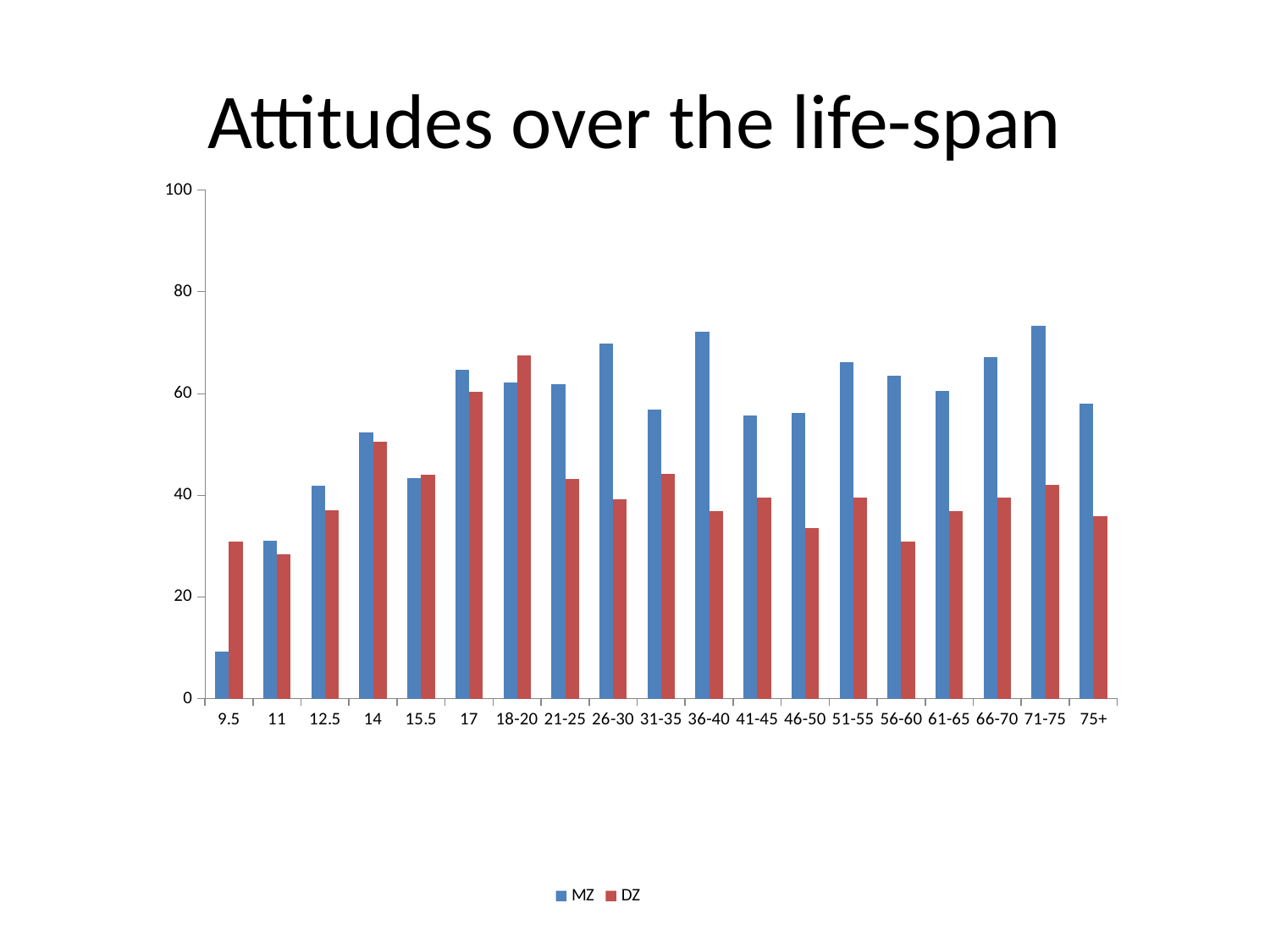
How many age categories are shown on the x axis? 19 Is the MZ value for 9.5 greater or less than 20? less For the 9.5 category, which series has the larger value, MZ or DZ? DZ Is the DZ value for 18-20 greater or less than 60? greater What is the title of the chart? Attitudes over the life-span For the 36-40 category, which series has the larger value, MZ or DZ? MZ Which age category has the highest DZ value? 18-20 Which age category has the lowest MZ value? 9.5 Is the DZ value for 46-50 greater or less than 40? less How many series does the legend list? 2 What kind of chart is shown on the slide? bar chart